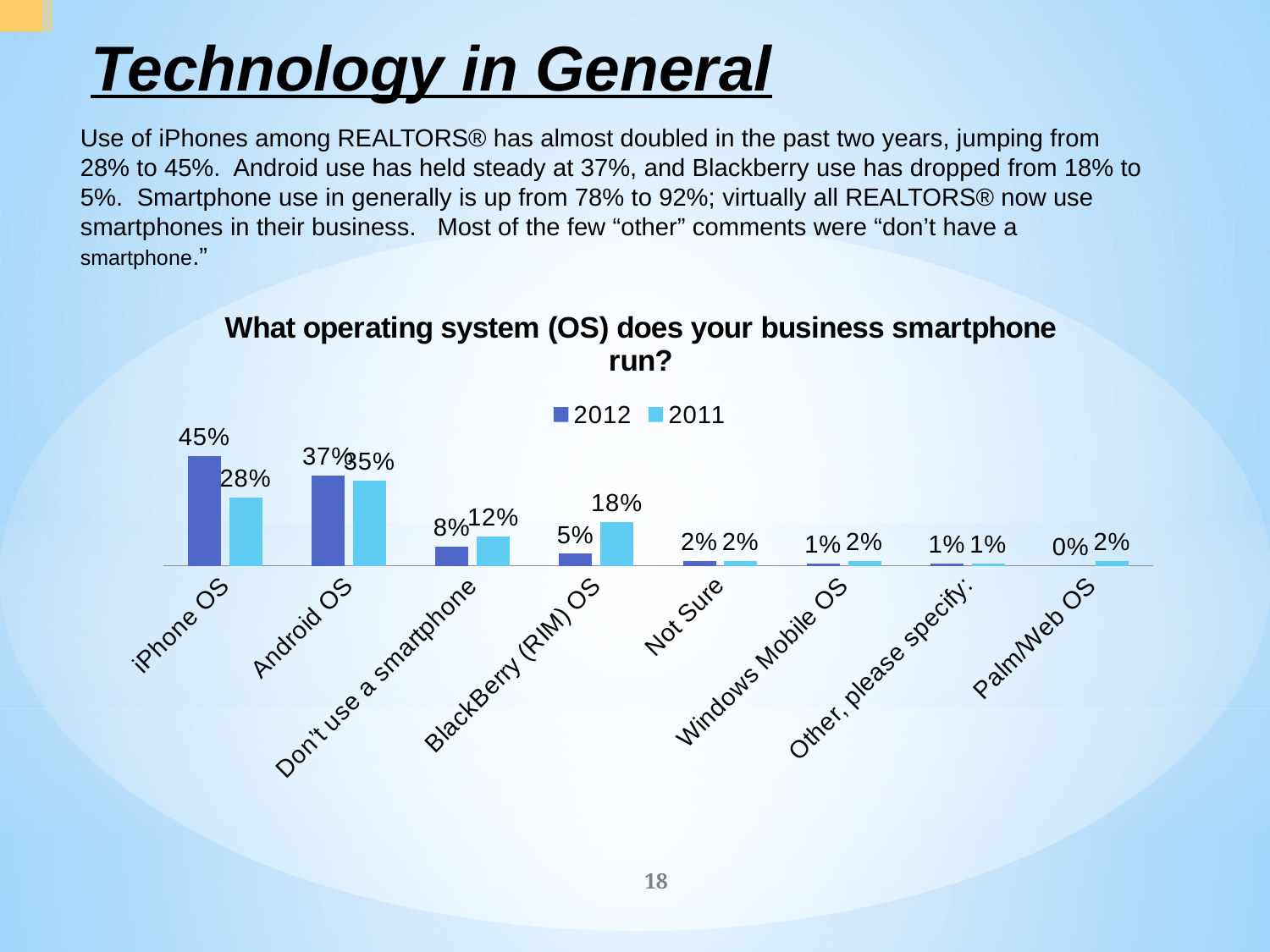
What is the 2012 value for iPhone OS? 45% Which is larger for Android OS, the 2012 value or the 2011 value? 2012 What is the difference between the 2012 and 2011 values for iPhone OS? 17% What kind of chart is shown on the slide? Bar chart What is the 2011 value for BlackBerry (RIM) OS? 18% What is the difference between the 2011 and 2012 values for BlackBerry (RIM) OS? 13% What is the 2012 value for Palm/Web OS? 0% How many categories are shown on the x axis? 8 What is the 2011 value for Don't use a smartphone? 12% How many series does the legend list? 2 Which category has the lowest 2012 value? Palm/Web OS Which category has the highest 2012 value? iPhone OS